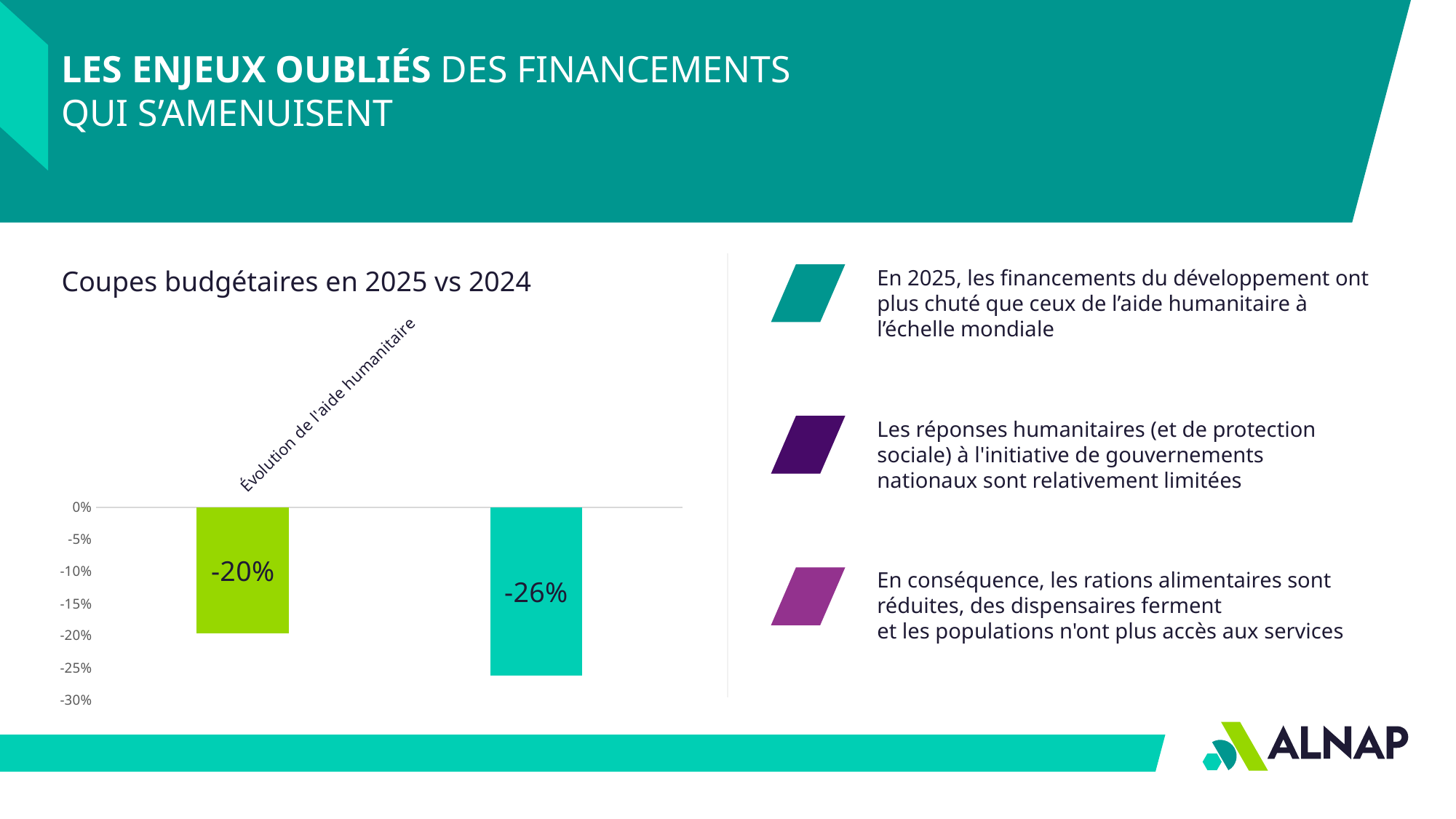
What value is printed on the teal (second) bar of the chart? -26% Are the values plotted in the chart positive or negative? Negative What kind of chart is shown on the slide? Bar chart How many bars are plotted in the chart? 2 Which bar has the lowest value in the chart? The teal (second) bar, at -26% What colour is the bar for "Évolution de l'aide humanitaire"? Green What is the difference between the two values shown in the chart, -20% and -26%? 6 percentage points Is the value for "Évolution de l'aide humanitaire" greater or less than -15%? less What is the title of the chart? Coupes budgétaires en 2025 vs 2024 What is the lowest tick value shown on the chart's vertical axis? -30% What value is shown for "Évolution de l'aide humanitaire" in the chart? -20% Which bar shows the larger cut: the green bar (Évolution de l'aide humanitaire) or the teal bar? The teal bar (-26%)